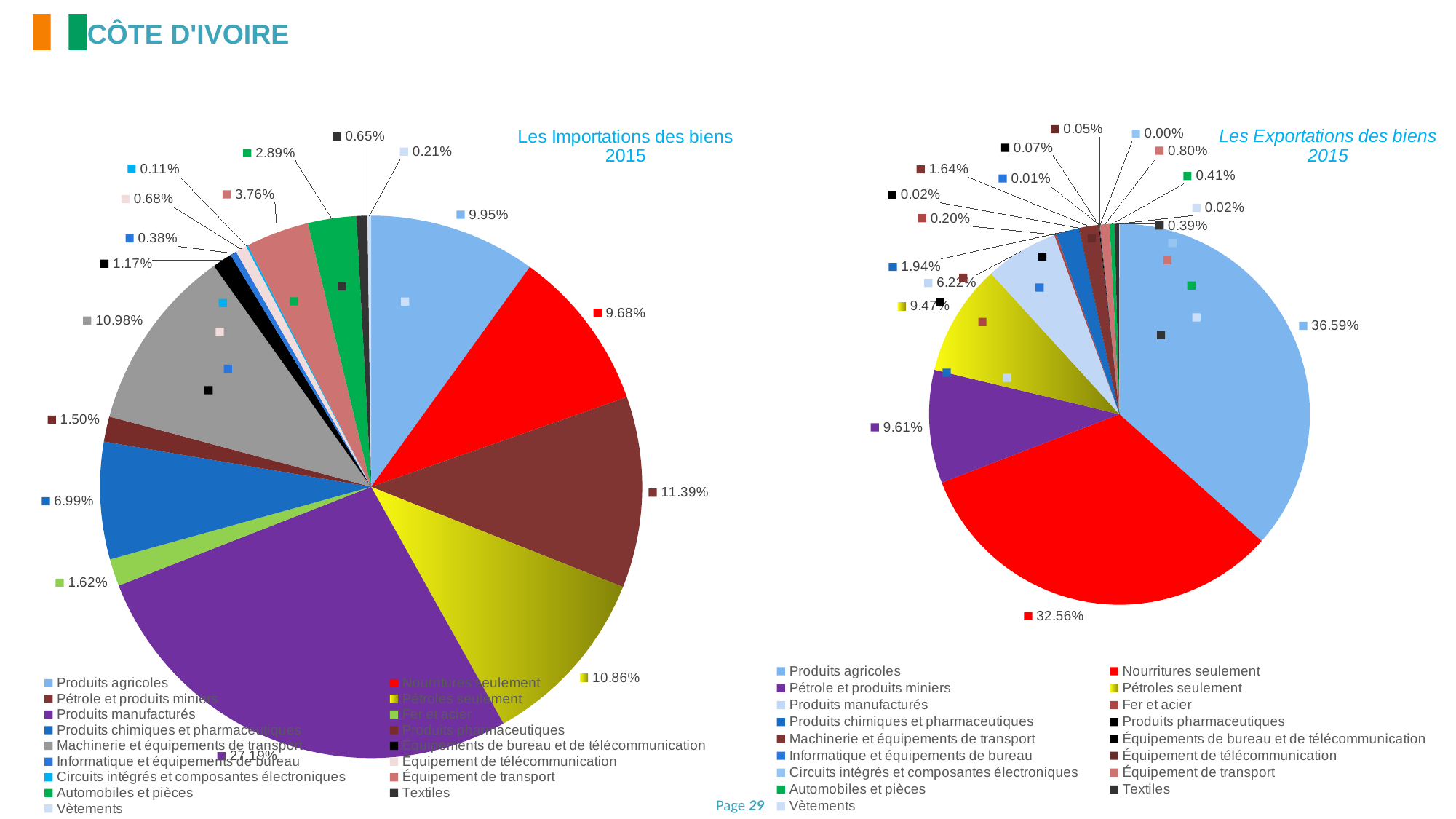
In the 'Les Importations des biens 2015' chart, which is larger: Produits agricoles or Nourritures seulement? Produits agricoles In the 'Les Importations des biens 2015' chart, which category has the largest slice? Produits manufacturés What kind of chart is used for 'Les Importations des biens 2015'? Pie chart In the 'Les Exportations des biens 2015' chart, what is the value for Nourritures seulement? 32.56% In the 'Les Exportations des biens 2015' chart, what is the difference between Produits agricoles and Nourritures seulement? 4.03% In the 'Les Importations des biens 2015' chart, what is the difference between Produits manufacturés and Pétrole et produits miniers? 15.80% In the 'Les Importations des biens 2015' chart, what is the value for Machinerie et équipements de transport? 10.98% In the 'Les Importations des biens 2015' chart, what share do Produits manufacturés have? 27.19% In the 'Les Exportations des biens 2015' chart, what share do Produits agricoles have? 36.59% How many categories does the legend of the 'Les Exportations des biens 2015' chart list? 17 In the 'Les Exportations des biens 2015' chart, which category has the largest slice? Produits agricoles In the 'Les Importations des biens 2015' chart, what is the value for Pétrole et produits miniers? 11.39%